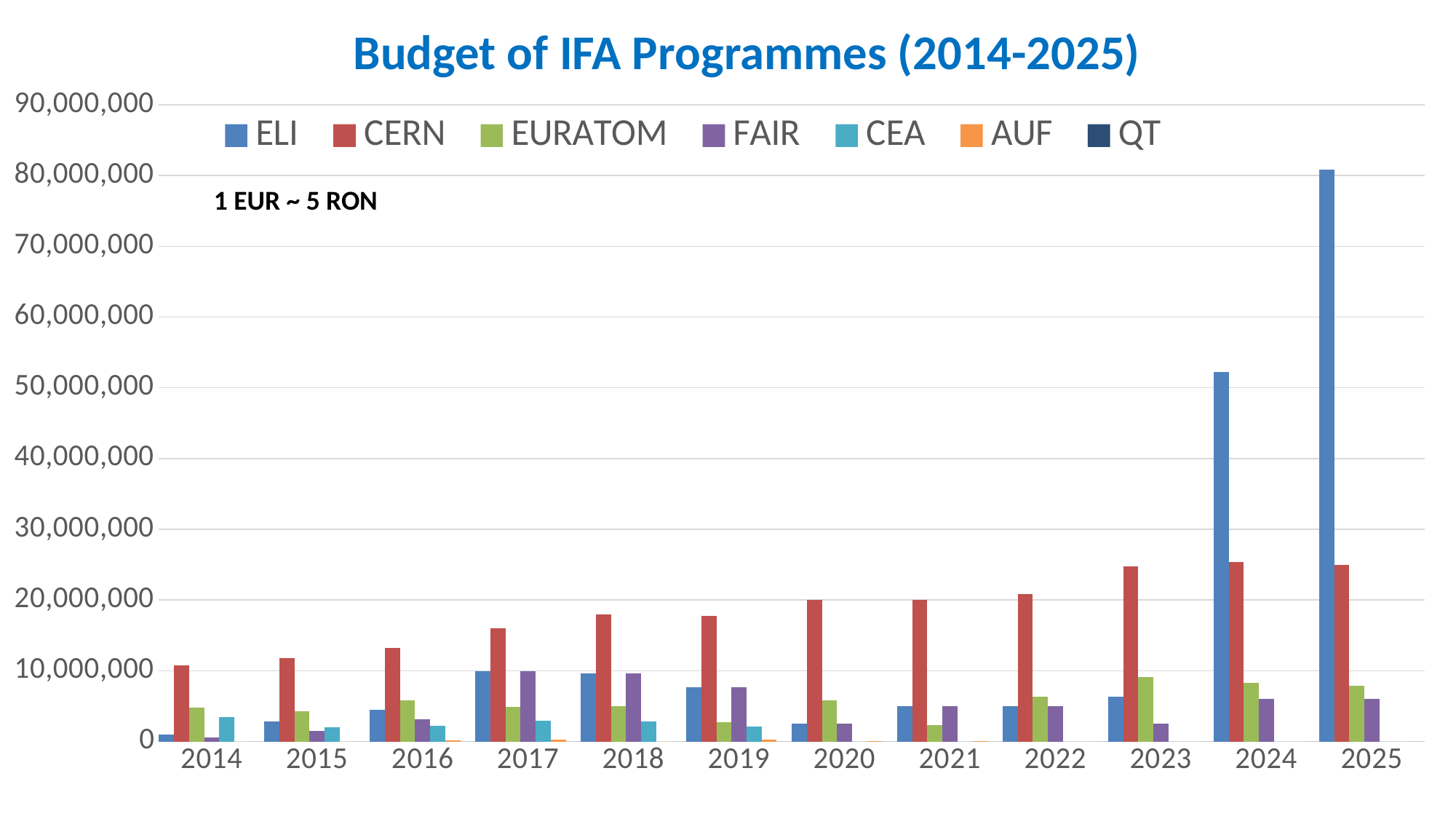
Does the CERN budget generally rise or fall from 2014 to 2025? rise How many years are shown on the x axis? 12 How many series does the legend list? 7 In 2025, which is larger: the ELI budget or the CERN budget? ELI Is the value for ELI in 2025 greater or less than 70,000,000? greater In which year is the ELI budget lowest? 2014 What kind of chart is shown on the slide? bar chart Is the value for CERN in 2023 greater or less than 30,000,000? less In which year is the ELI budget highest? 2025 Which programme has the highest budget in 2020? CERN Is the value for ELI in 2024 greater or less than 40,000,000? greater In 2014, which is larger: the CERN budget or the ELI budget? CERN